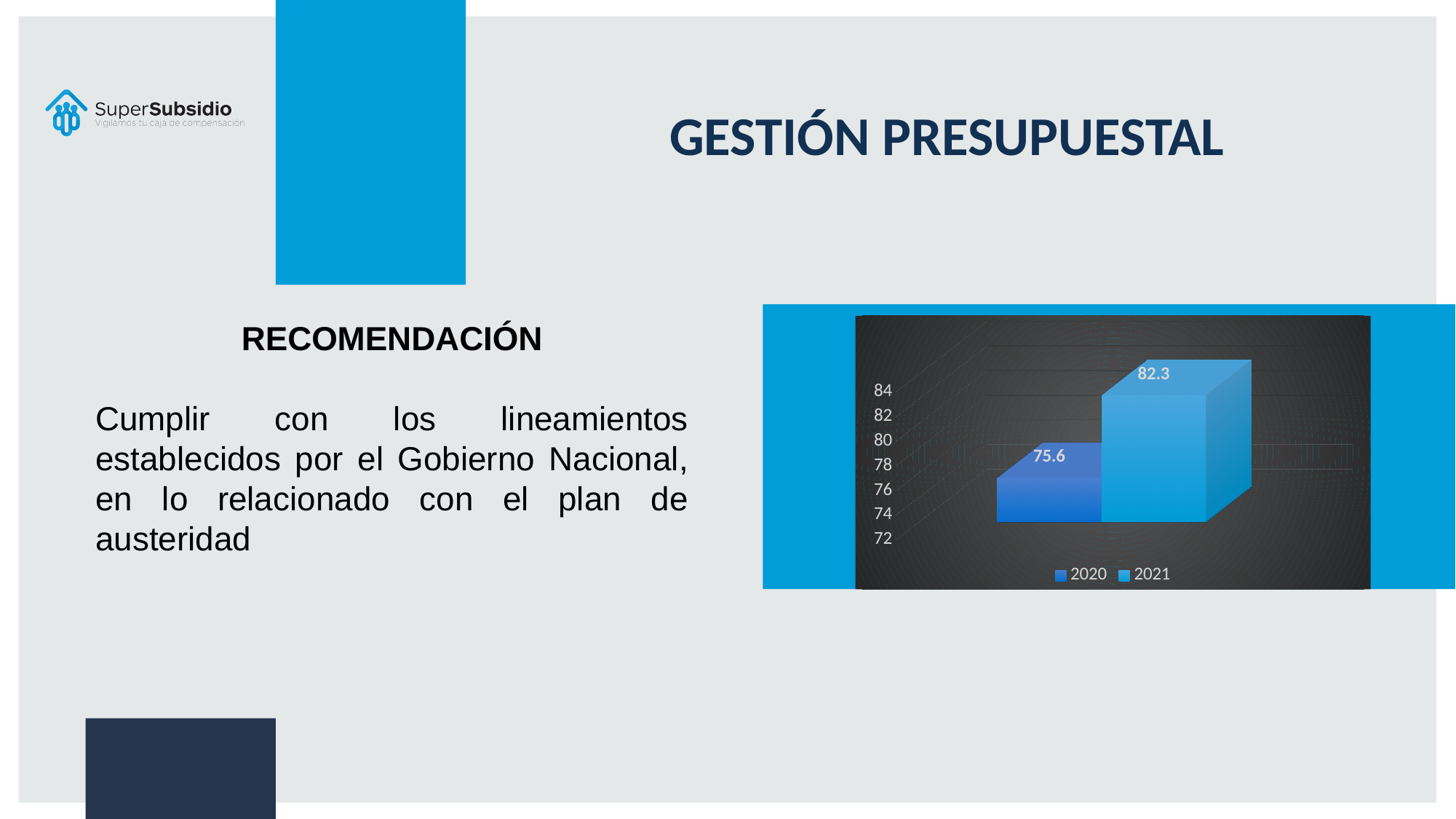
What is the value for 2021 in the chart? 82.3 Is the value for 2021 greater or less than 80? greater Is the value for 2021 larger or smaller than the value for 2020? larger Is the value for 2020 greater or less than 80? less Does the value rise or fall from 2020 to 2021? rise What are the legend entries of the chart? 2020, 2021 What kind of chart is shown on the slide? bar chart How many series does the chart legend list? 2 Which year has the lower value in the chart? 2020 What is the difference between the 2021 and 2020 values in the chart? 6.7 What is the value for 2020 in the chart? 75.6 Which year has the higher value in the chart? 2021